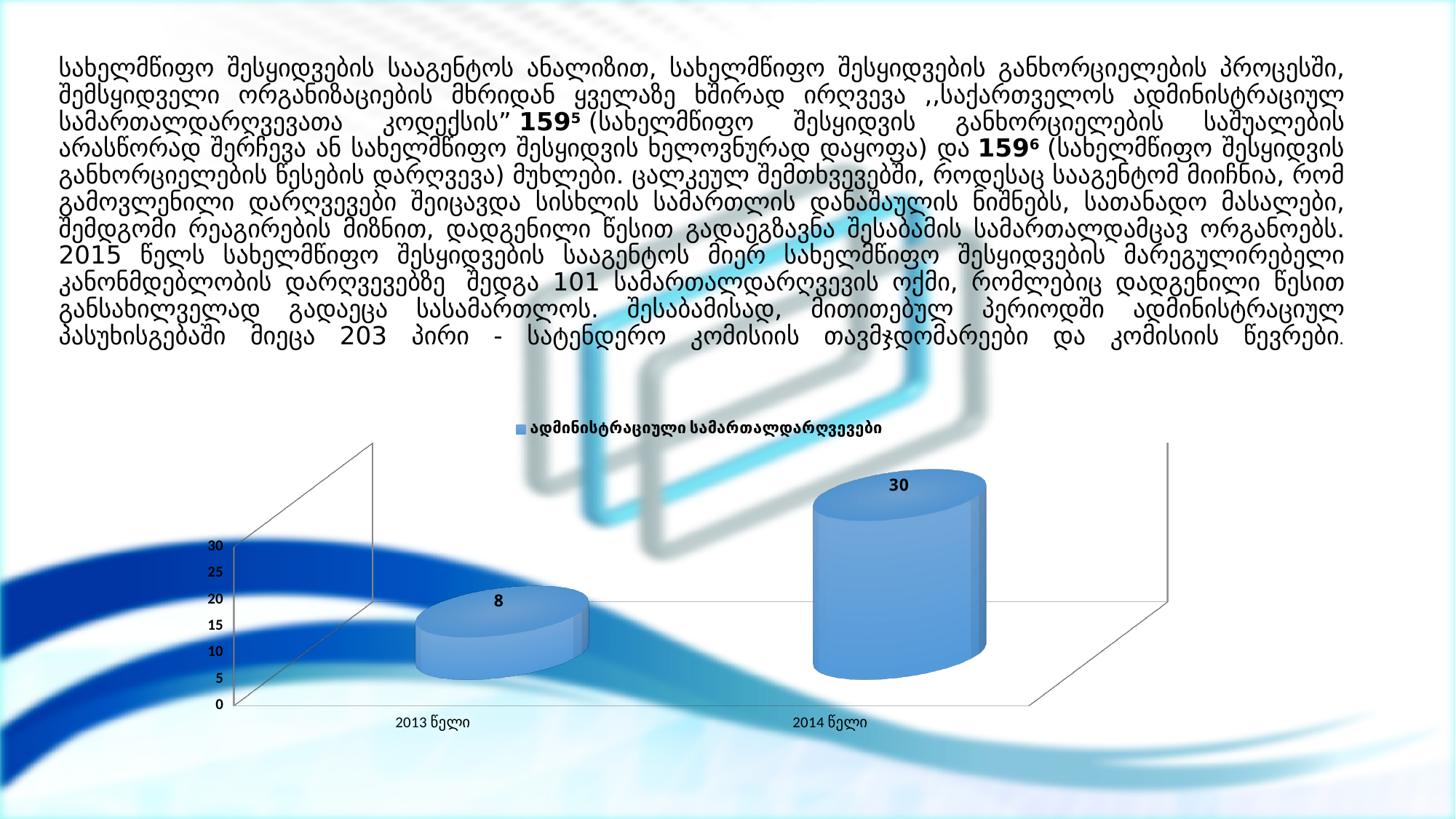
What is the difference between the values for 2014 წელი and 2013 წელი? 22 Which year has the lowest value? 2013 წელი What is the value for 2013 წელი? 8 How many categories are shown on the x axis? 2 What is the value for 2014 წელი? 30 What kind of chart is shown on the slide? bar chart Which year has the highest value? 2014 წელი Is the value for 2013 წელი greater or less than 10? less Is the value for 2014 წელი greater or less than 25? greater Which is larger, the value for 2013 წელი or the value for 2014 წელი? 2014 წელი How many series does the legend list? 1 What is the name of the series shown in the legend? ადმინისტრაციული სამართალდარღვევები